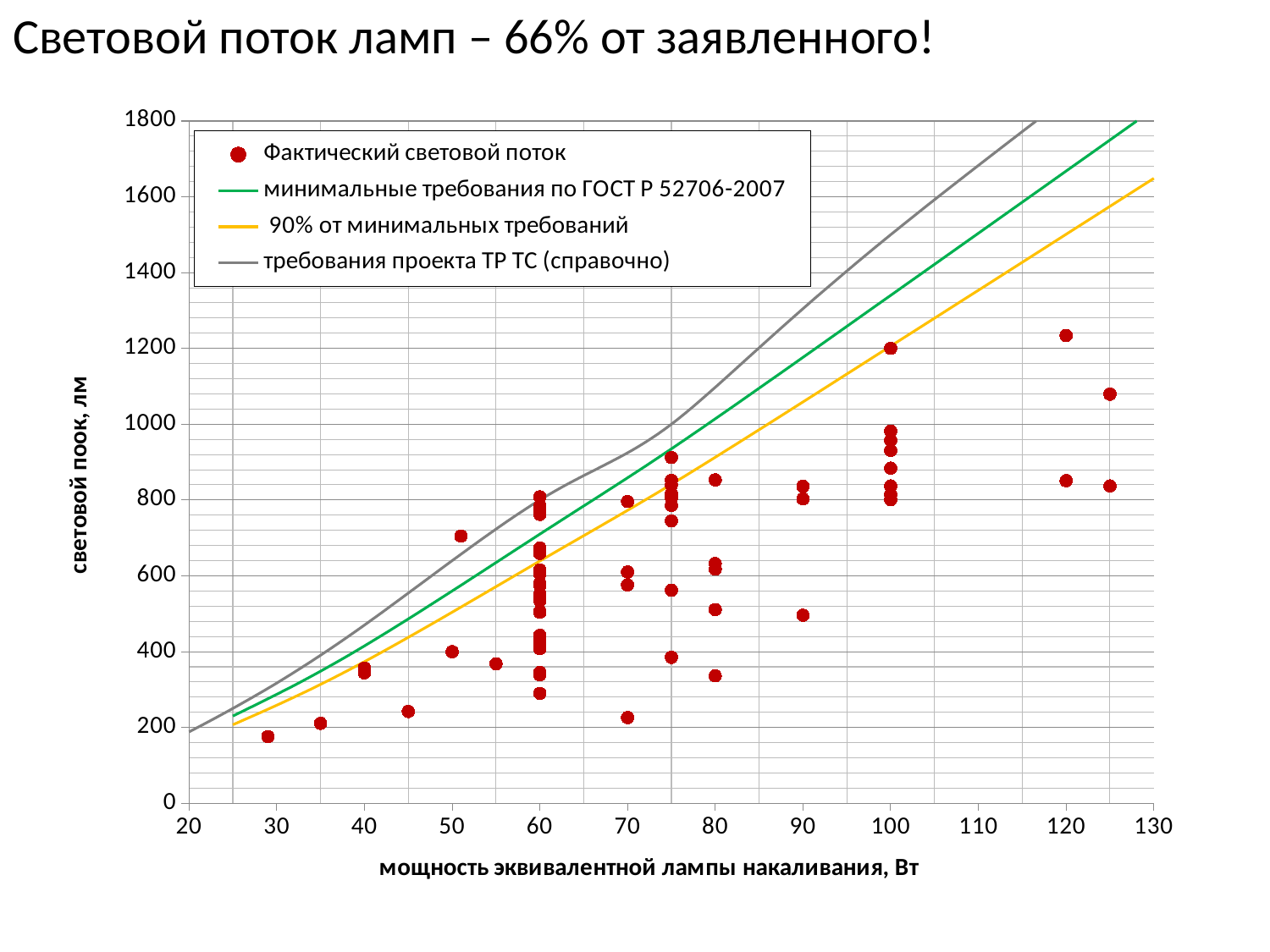
Is the highest actual light flux point at 100 W greater or less than 1000? greater Is the highest actual light flux point at 60 W greater or less than 1000? less Is the highest actual light flux point at 120 W greater or less than 1200? greater At 100 W, is the green ГОСТ line above or below the yellow 90% line? above Do the three requirement lines rise or fall as the power on the x axis increases? rise What kind of chart is shown on the slide? scatter chart How many series does the legend list? 4 Which line is highest at 130 W: the green, yellow or grey line? grey (требования проекта ТР ТС) What is the label of the horizontal axis? мощность эквивалентной лампы накаливания, Вт What is the title of the slide chart? Световой поток ламп – 66% от заявленного!